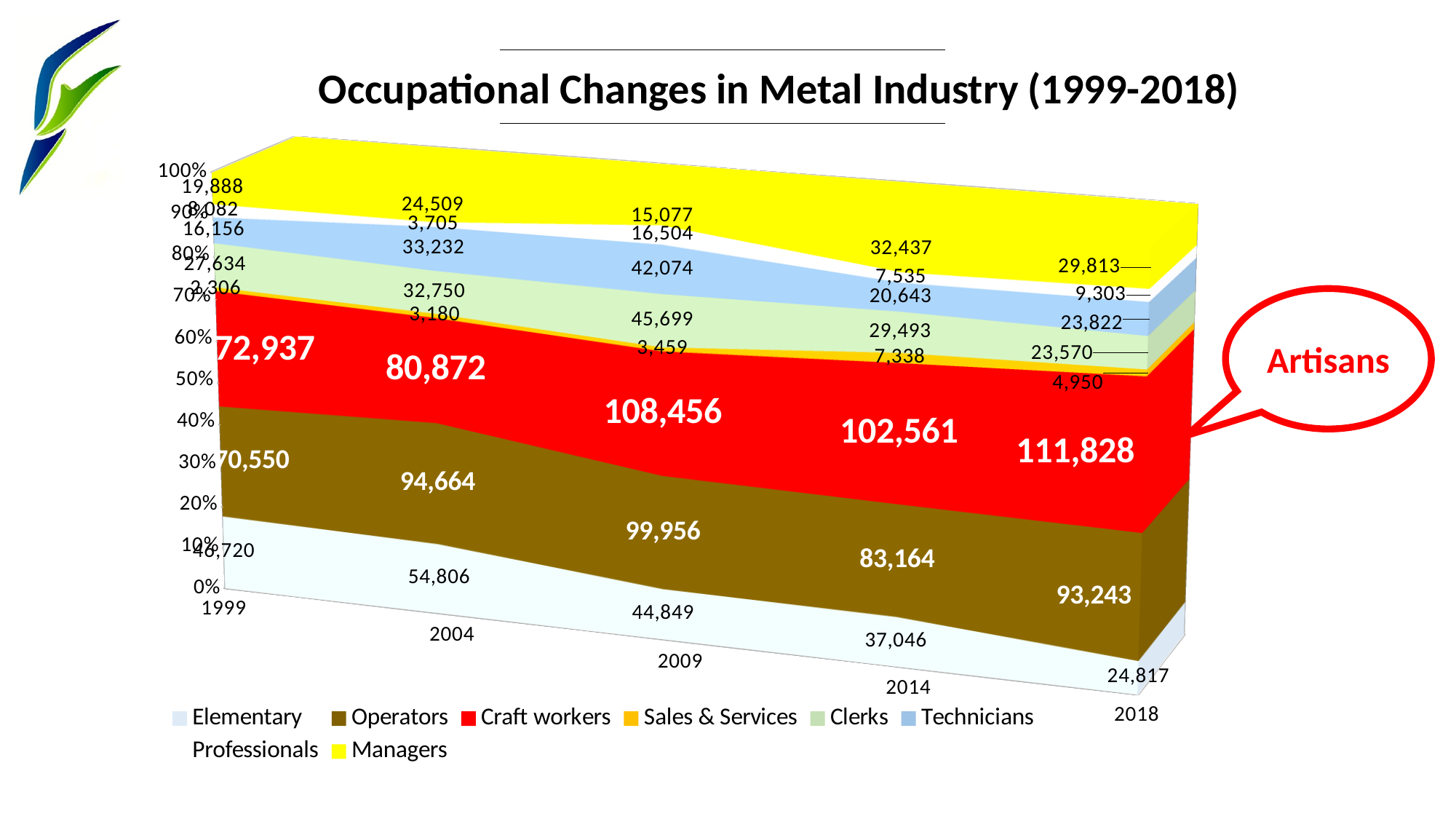
In which year is the Craft workers value highest? 2018 In which year is the Elementary value lowest? 2018 What kind of chart is this? Stacked area chart Which is larger in 2004: Operators or Craft workers? Operators What is the value for Craft workers in 2018? 111,828 What is the value for Operators in 2009? 99,956 How many series does the legend list? 8 How many years are shown on the x axis? 5 What is the difference between the Craft workers values in 2018 and 1999? 38,891 Does the Elementary value rise or fall from 2004 to 2018? Fall What is the value for Managers in 2014? 32,437 What is the value for Elementary in 1999? 46,720